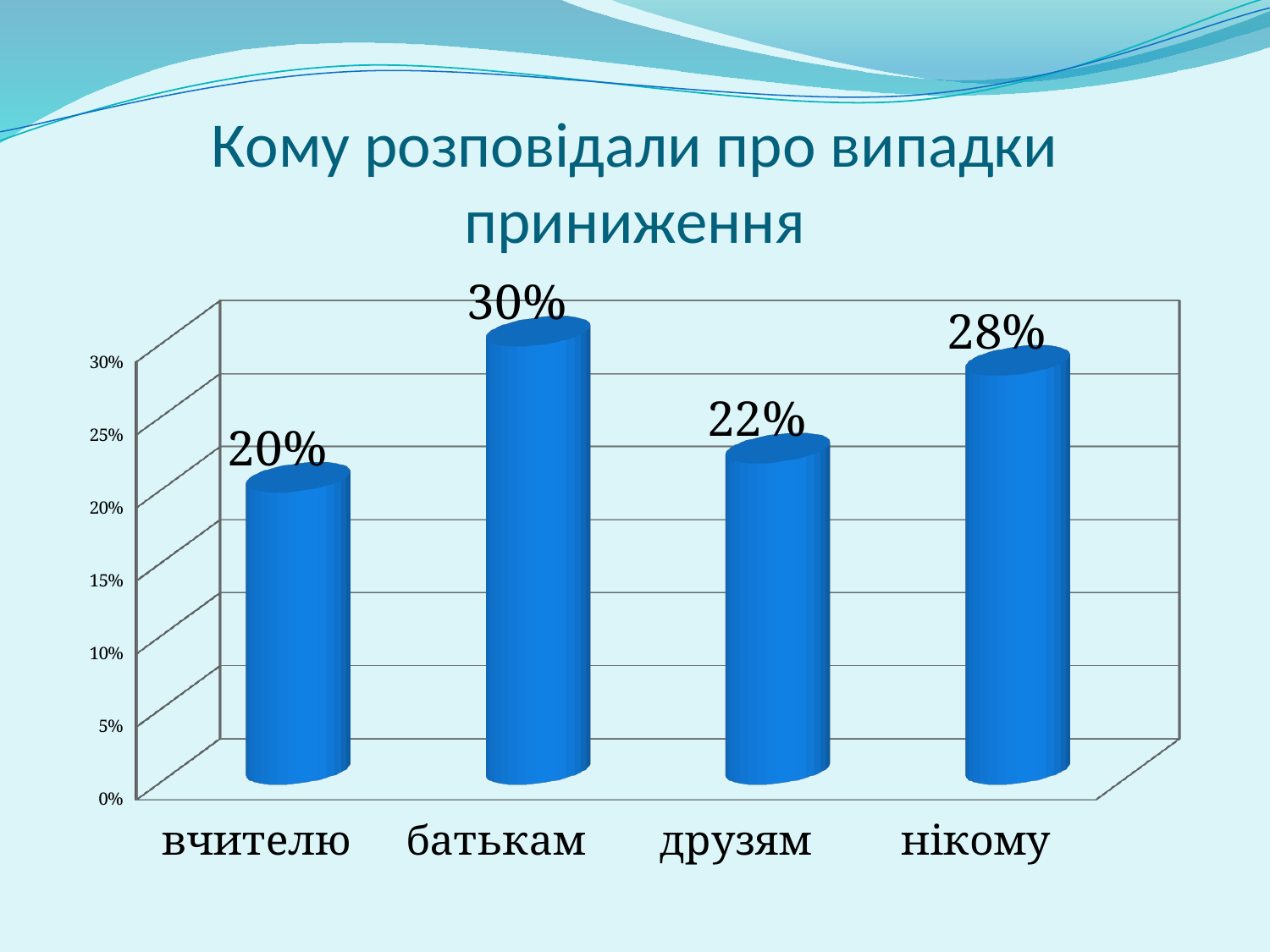
How many categories are shown on the x axis? 4 Which is larger, the value for нікому or the value for друзям? нікому What is the value for батькам? 30% What kind of chart is shown on the slide? bar chart Which category has the highest value? батькам What is the value for нікому? 28% Which category has the lowest value? вчителю What is the value for вчителю? 20% What is the difference between the values for нікому and друзям? 6% What is the difference between the values for батькам and вчителю? 10% What is the title of the chart? Кому розповідали про випадки приниження What is the value for друзям? 22%